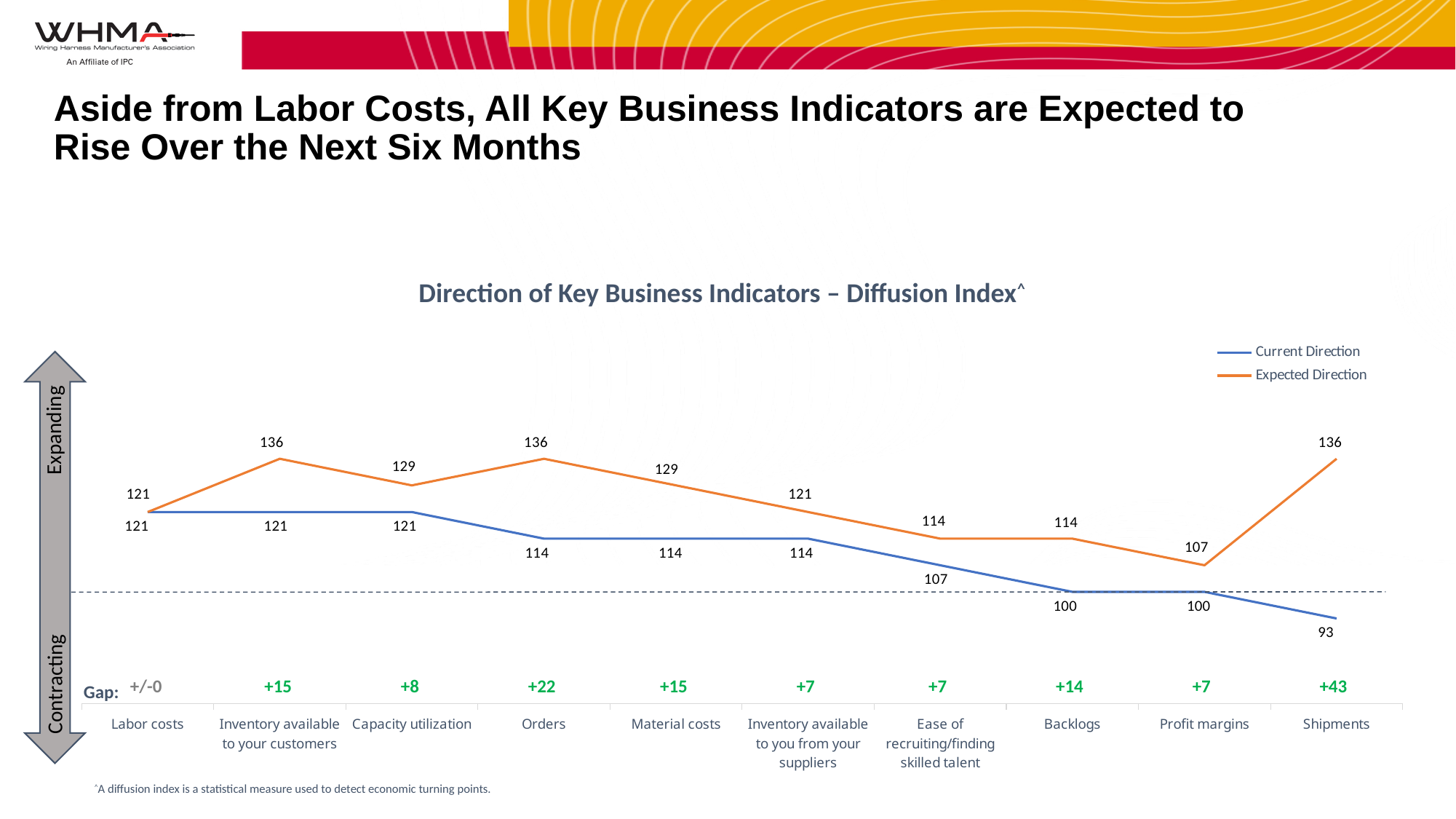
How many categories are shown on the x axis? 10 What is the Expected Direction value for Capacity utilization? 129 Which category has the lowest Expected Direction value? Profit margins What is the Expected Direction value for Shipments? 136 How many series does the legend list? 2 What kind of chart is this? Line chart Does the Current Direction line rise or fall from Labor costs to Shipments? Fall What is the Gap value shown for Shipments? +43 Which category has the lowest Current Direction value? Shipments What is the difference between the Expected Direction and Current Direction values for Orders? 22 What is the Current Direction value for Orders? 114 Which is larger for Backlogs: the Current Direction value or the Expected Direction value? Expected Direction